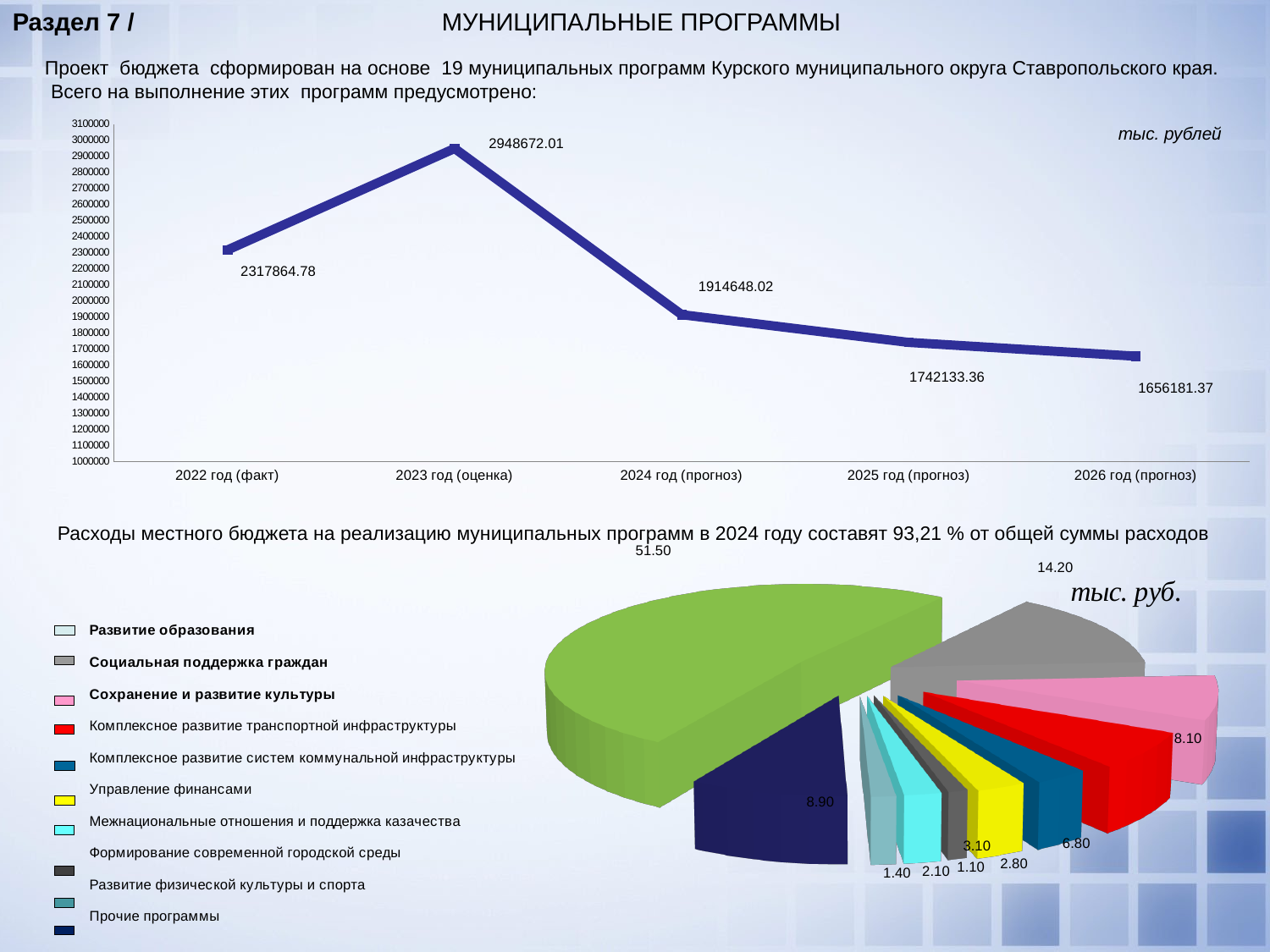
On the top line chart, what is the difference between the values for 2024 год (прогноз) and 2025 год (прогноз)? 172514.66 On the top line chart, how many years are plotted along the x axis? 5 On the bottom pie chart, how many entries does the legend list? 10 On the top line chart, which year has the highest value? 2023 год (оценка) On the top line chart, what is the value for 2023 год (оценка)? 2948672.01 On the top line chart, what is the value for 2026 год (прогноз)? 1656181.37 On the top line chart, do the values rise or fall from 2023 год (оценка) to 2026 год (прогноз)? fall On the top line chart, what is the difference between the values for 2023 год (оценка) and 2022 год (факт)? 630807.23 On the top line chart, what is the value for 2022 год (факт)? 2317864.78 On the top line chart, which year has the lowest value? 2026 год (прогноз) On the top line chart, which is larger: the value for 2024 год (прогноз) or 2025 год (прогноз)? 2024 год (прогноз) What kind of chart is the bottom chart on the slide? pie chart